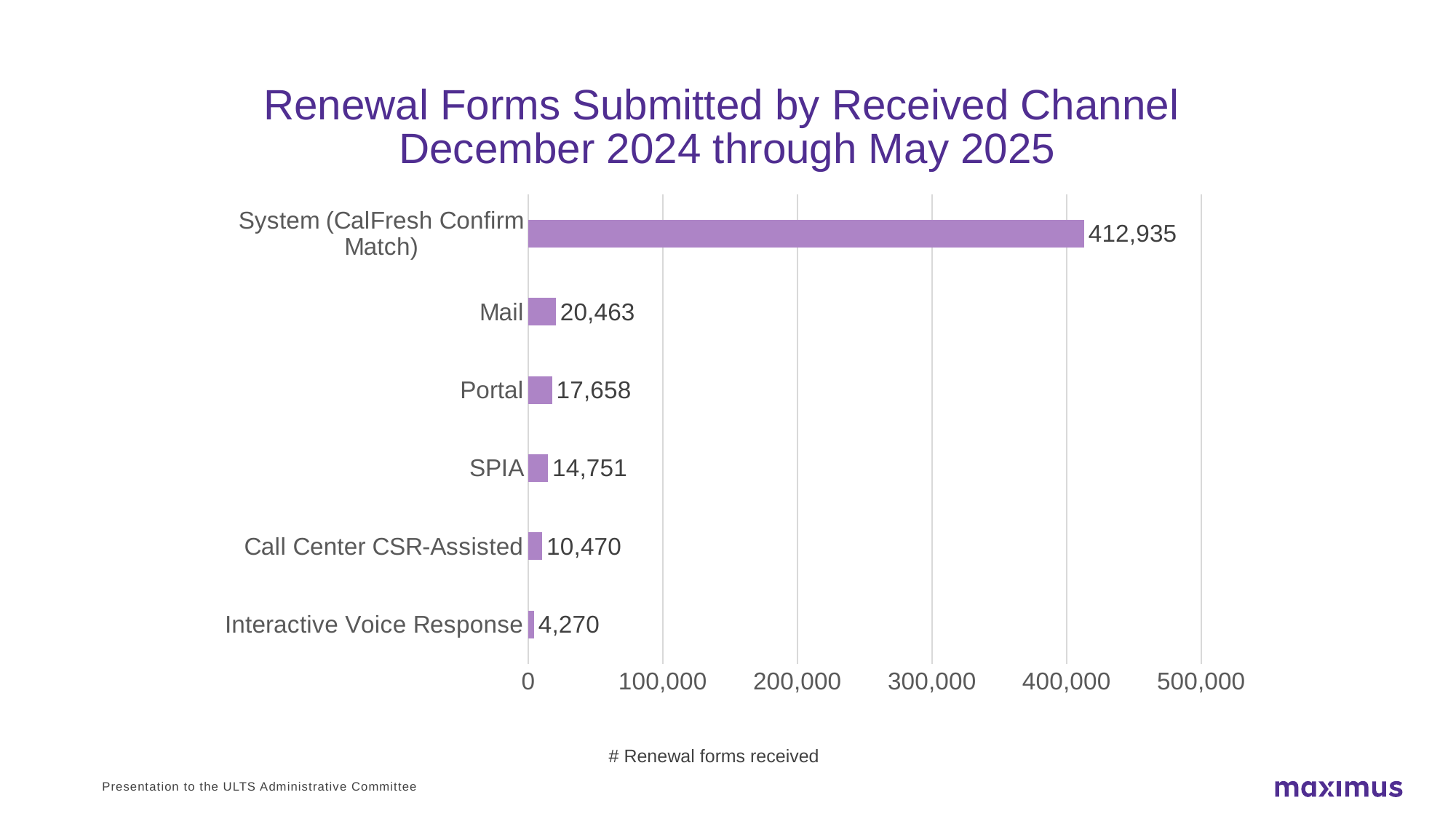
Which is larger, the value for SPIA or the value for Call Center CSR-Assisted? SPIA How many renewal forms were received via Interactive Voice Response? 4,270 What is the difference between the Mail and Portal values? 2,805 What kind of chart is shown on the slide? bar chart Is the value for System (CalFresh Confirm Match) greater or less than 400,000? greater What is the value for Portal? 17,658 Which channel has the lowest number of renewal forms received? Interactive Voice Response What is the label on the horizontal axis of the chart? # Renewal forms received What is the value for Call Center CSR-Assisted? 10,470 How many renewal forms were received through Mail? 20,463 How many channels are shown in the chart? 6 Which channel has the highest number of renewal forms received? System (CalFresh Confirm Match)